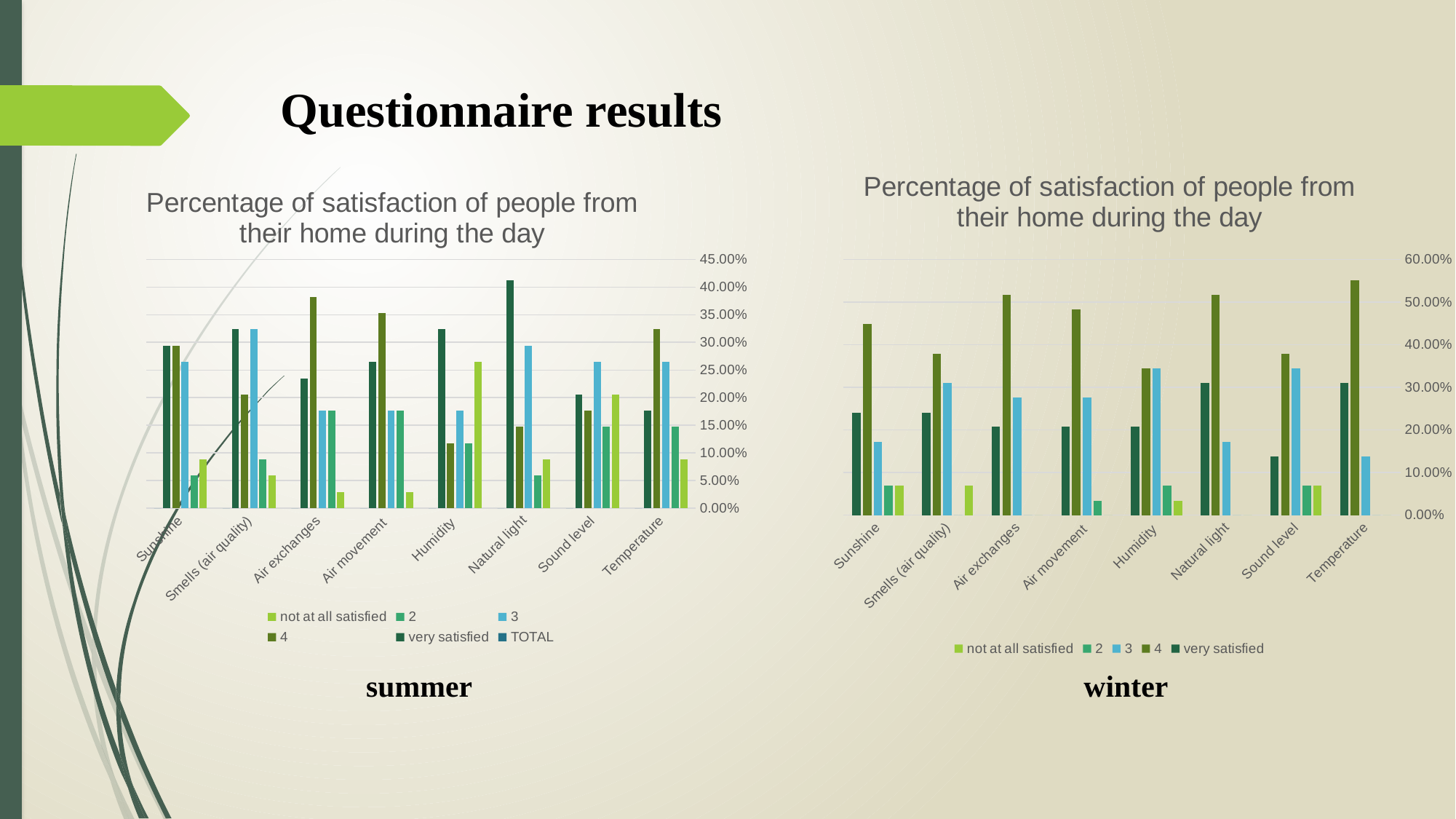
What type of chart is the summer chart on the left? bar chart In the summer chart, is the '4' value for Air exchanges greater or less than 35.00%? greater How many series does the legend of the winter chart list? 5 In the summer chart, which category has the highest 'very satisfied' value? Natural light In the winter chart, is the 'very satisfied' value for Sound level greater or less than 20.00%? less In the winter chart, is the value of the '4' series for Temperature greater or less than 50.00%? greater How many series does the legend of the summer chart list? 6 In the summer chart, which is larger: the 'not at all satisfied' value for Humidity or for Sound level? Humidity Which series appears in the summer chart's legend but not in the winter chart's legend? TOTAL In the winter chart, for Sunshine, which is larger: the '4' series or the '3' series? 4 How many categories are shown on the x axis of the winter chart? 8